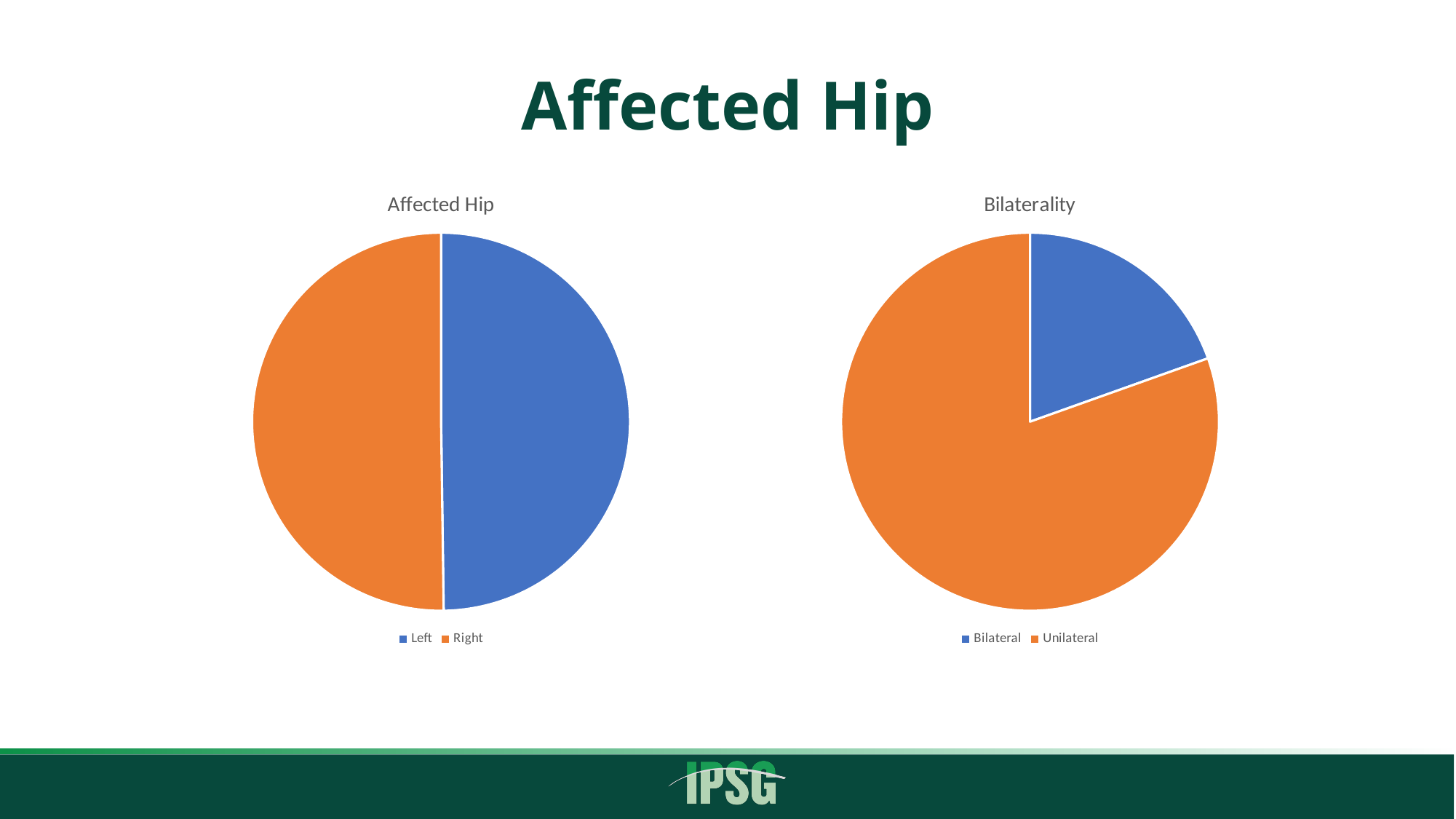
How many entries does the legend of the "Bilaterality" chart list? 2 How many slices does the "Affected Hip" pie chart have? 2 How many entries does the legend of the "Affected Hip" chart list? 2 What kind of chart is the "Bilaterality" chart on the right? Pie chart In the "Bilaterality" chart, what colour is the Unilateral slice? Orange What are the two categories in the legend of the "Affected Hip" chart? Left and Right What kind of chart is the "Affected Hip" chart on the left? Pie chart How many slices does the "Bilaterality" pie chart have? 2 In the "Bilaterality" chart, which slice is larger, Bilateral or Unilateral? Unilateral In the "Bilaterality" chart, which category has the smallest slice? Bilateral In the "Bilaterality" chart, which category has the largest slice? Unilateral